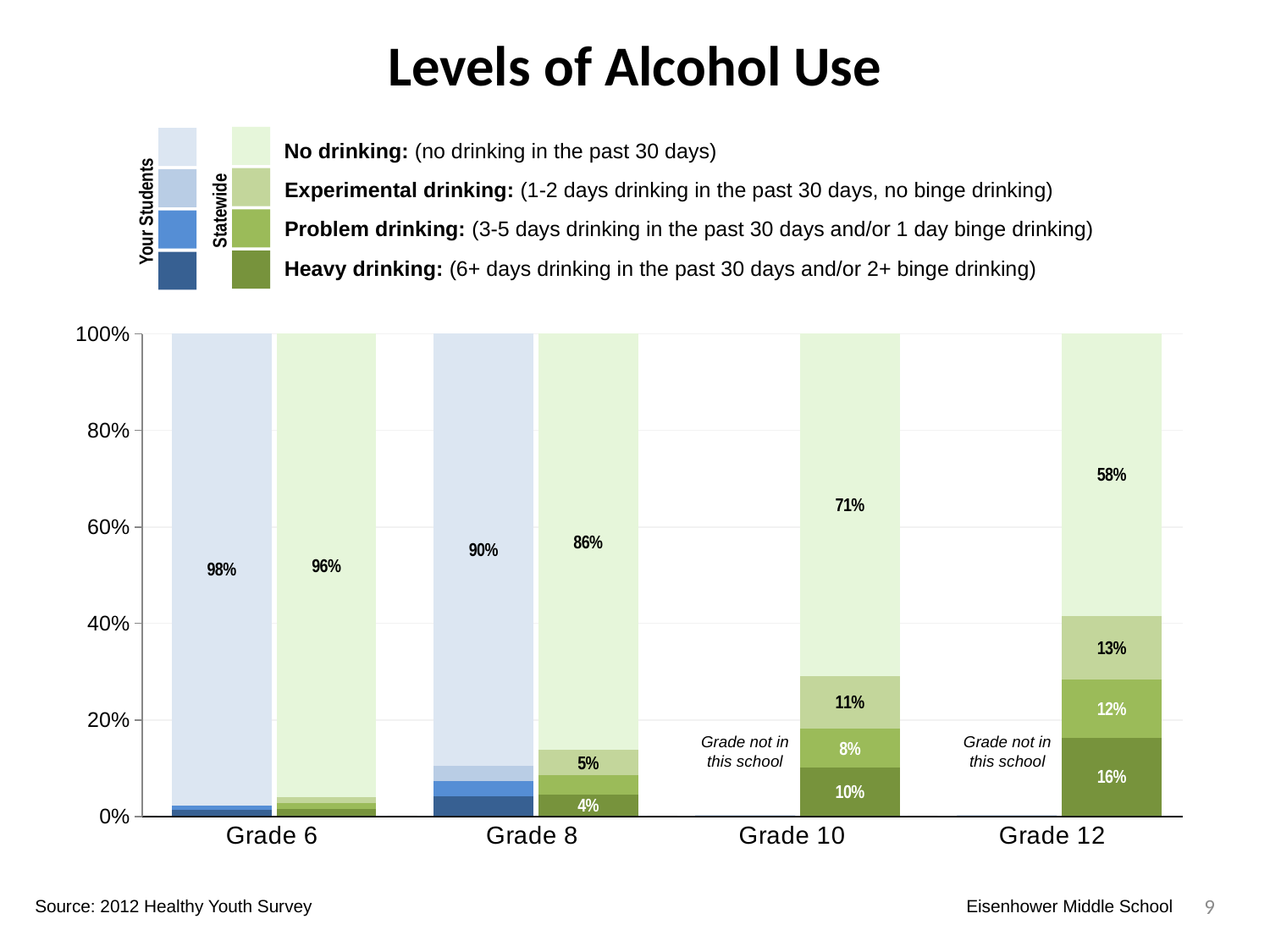
Which grades are marked 'Grade not in this school' for Your Students? Grade 10 and Grade 12 What percentage of Your Students in Grade 6 reported no drinking? 98% What is the Statewide heavy drinking percentage for Grade 12? 16% What is the Statewide no-drinking percentage for Grade 6? 96% For Grade 6, which has the higher no-drinking percentage: Your Students or Statewide? Your Students Which grade has the lowest Statewide no-drinking percentage? Grade 12 What is the Statewide experimental drinking percentage for Grade 12? 13% For Grade 8, how many percentage points higher is the no-drinking share for Your Students than Statewide? 4 percentage points What percentage of Your Students in Grade 8 reported no drinking? 90% How many grade categories are shown on the x axis? 4 What is the Statewide no-drinking percentage for Grade 10? 71% Does the Statewide no-drinking percentage rise or fall from Grade 6 to Grade 12? Fall